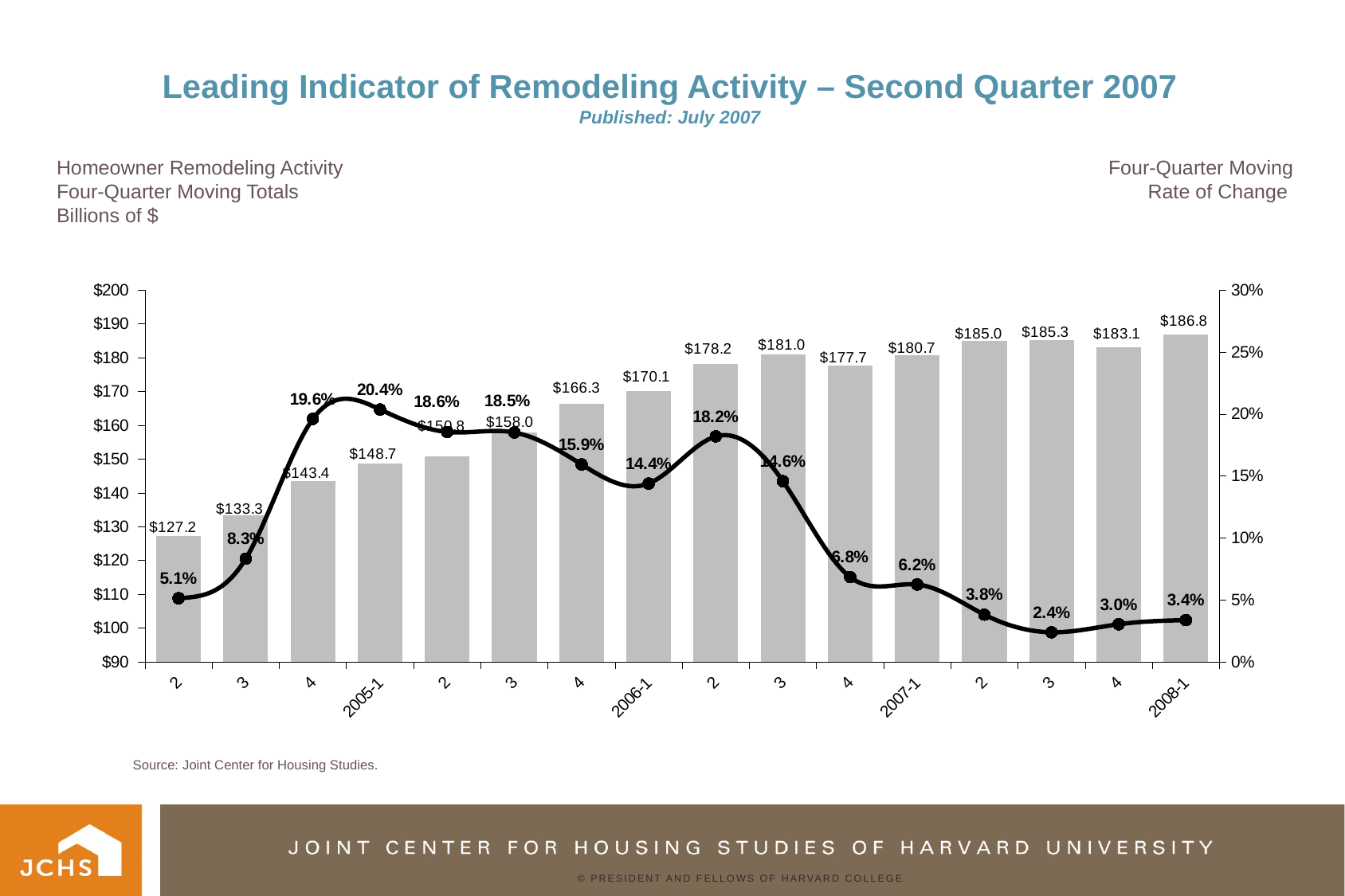
Do the homeowner remodeling activity bars rise or fall from 2005-1 to 2006-1? rise Which is larger, the four-quarter moving total for 2006-1 or for 2007-1? 2007-1 What is the lowest four-quarter moving rate of change shown on the line? 2.4% What is the highest four-quarter moving rate of change shown on the line, and at which quarter does it occur? 20.4% at 2005-1 What is the four-quarter moving rate of change at 2007-1? 6.2% How much higher is the four-quarter moving total for 2008-1 than for 2007-1? $6.1 Is the four-quarter moving total for 2006-1 greater or less than $160? greater How many bars are plotted in the chart? 16 What is the homeowner remodeling activity four-quarter moving total for 2008-1? $186.8 Which quarter has the highest homeowner remodeling activity bar? 2008-1 What is the homeowner remodeling activity four-quarter moving total for 2005-1? $148.7 What kind of chart is shown on the slide? A bar chart combined with a line chart